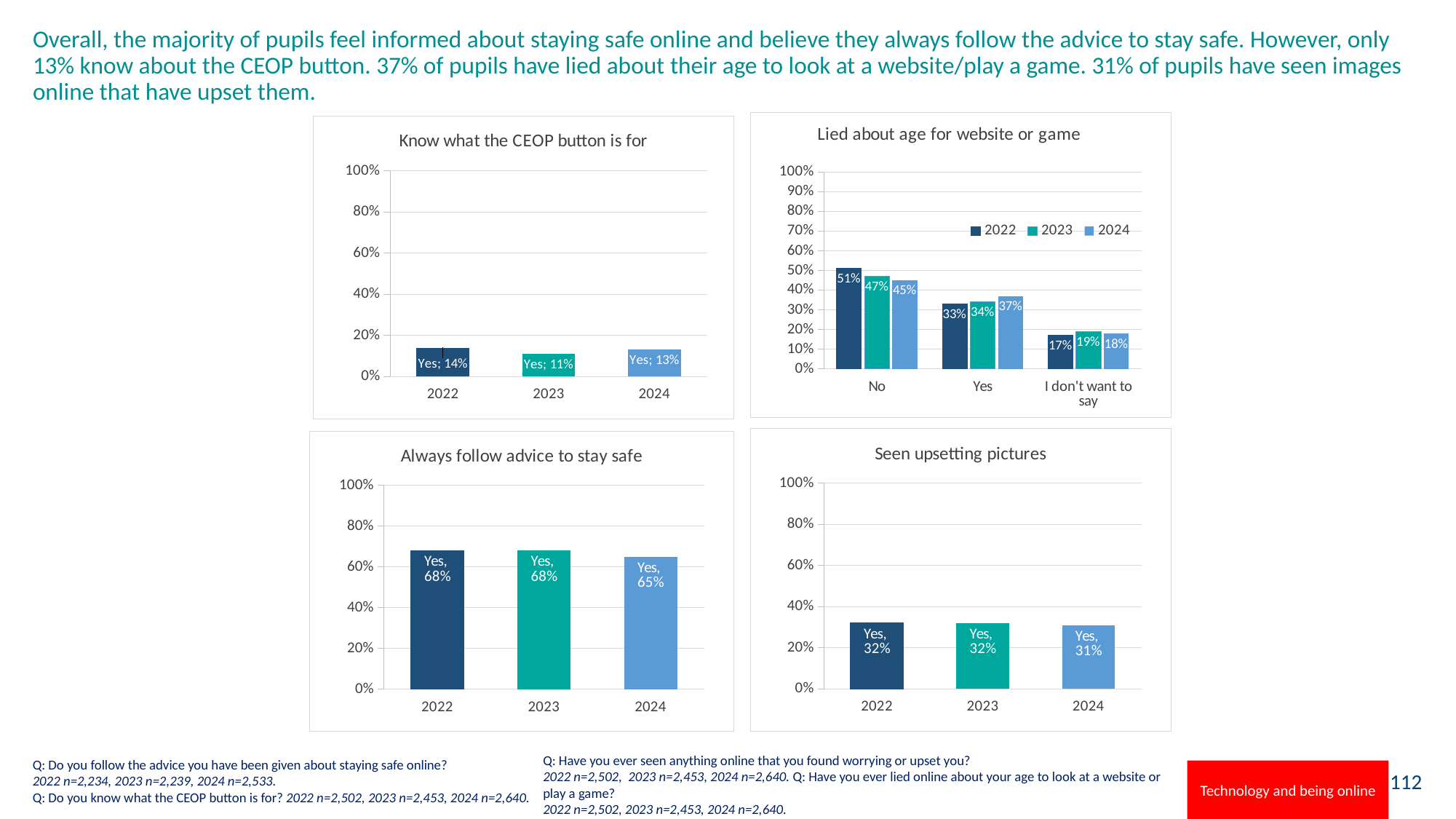
In the 'Lied about age for website or game' chart, what is the difference between the 2022 and 2024 values for 'No'? 6% In the 'Lied about age for website or game' chart, which response category has the highest values across all years? No In the 'Lied about age for website or game' chart, what is the 2022 value for 'No'? 51% In the 'Always follow advice to stay safe' chart, is the value for 2022 greater or less than 60%? greater In the 'Lied about age for website or game' chart, how many series does the legend list? 3 In the 'Always follow advice to stay safe' chart, what is the value for 2024? 65% What type of chart is the 'Seen upsetting pictures' chart? Bar chart In the 'Know what the CEOP button is for' chart, what is the value for 2024? 13% In the 'Lied about age for website or game' chart, what is the 2024 value for 'Yes'? 37% In the 'Seen upsetting pictures' chart, what is the value for 2023? 32% In the 'Know what the CEOP button is for' chart, which year has the lowest value? 2023 In the 'Seen upsetting pictures' chart, how many years are shown on the x axis? 3